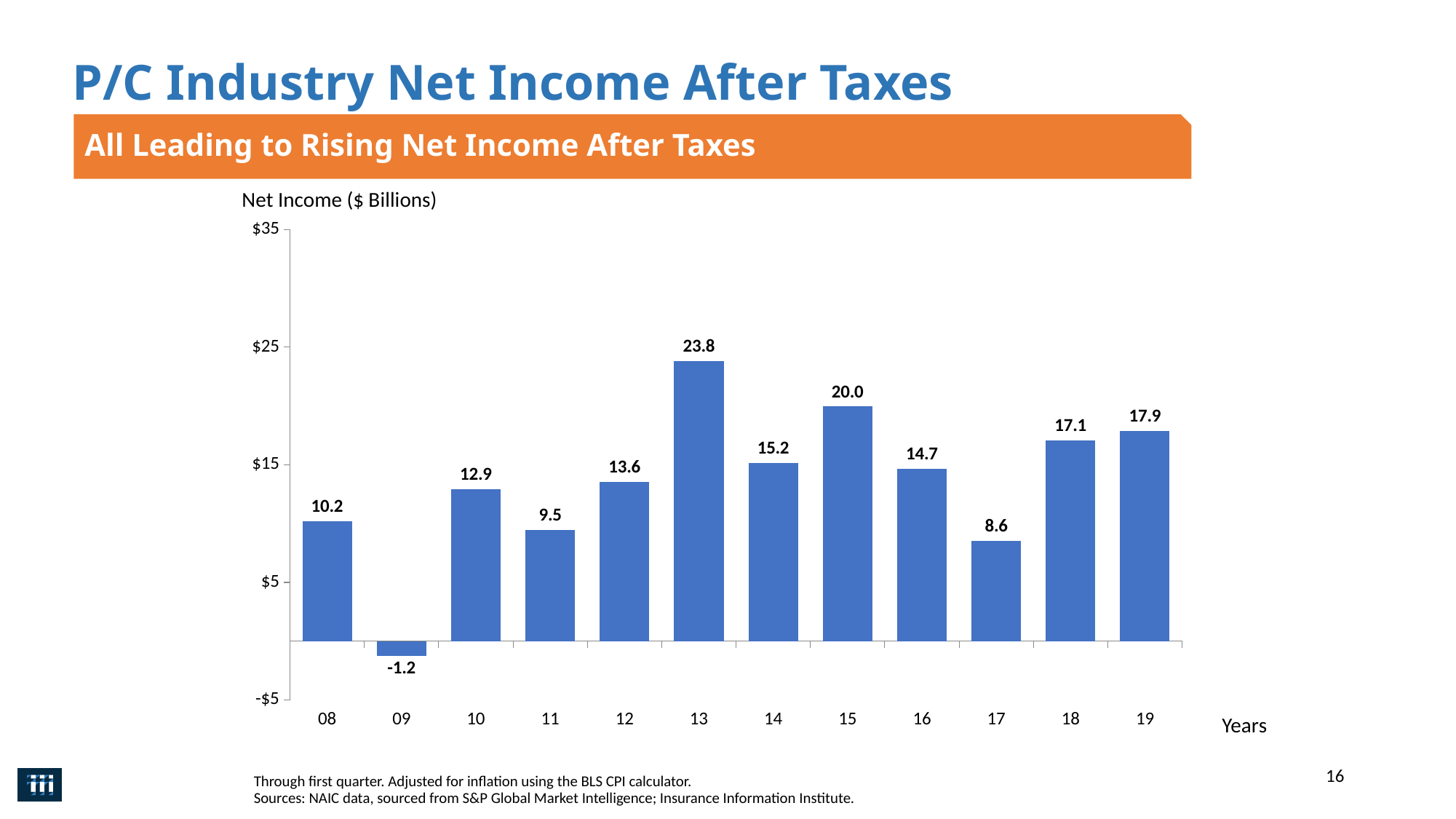
Which year has a larger net income, 18 or 19? 19 What is the net income value for year 13? 23.8 How many years are shown on the x axis? 12 What is the net income value for year 09? -1.2 What is the label of the y axis? Net Income ($ Billions) Does net income rise or fall from year 16 to year 17? fall What is the net income value for year 19? 17.9 Which year has the lowest net income? 09 What is the difference between the net income for year 15 and year 17? 11.4 Is the value for year 14 greater or less than $15? greater What kind of chart is shown on the slide? bar chart Which year has the highest net income? 13